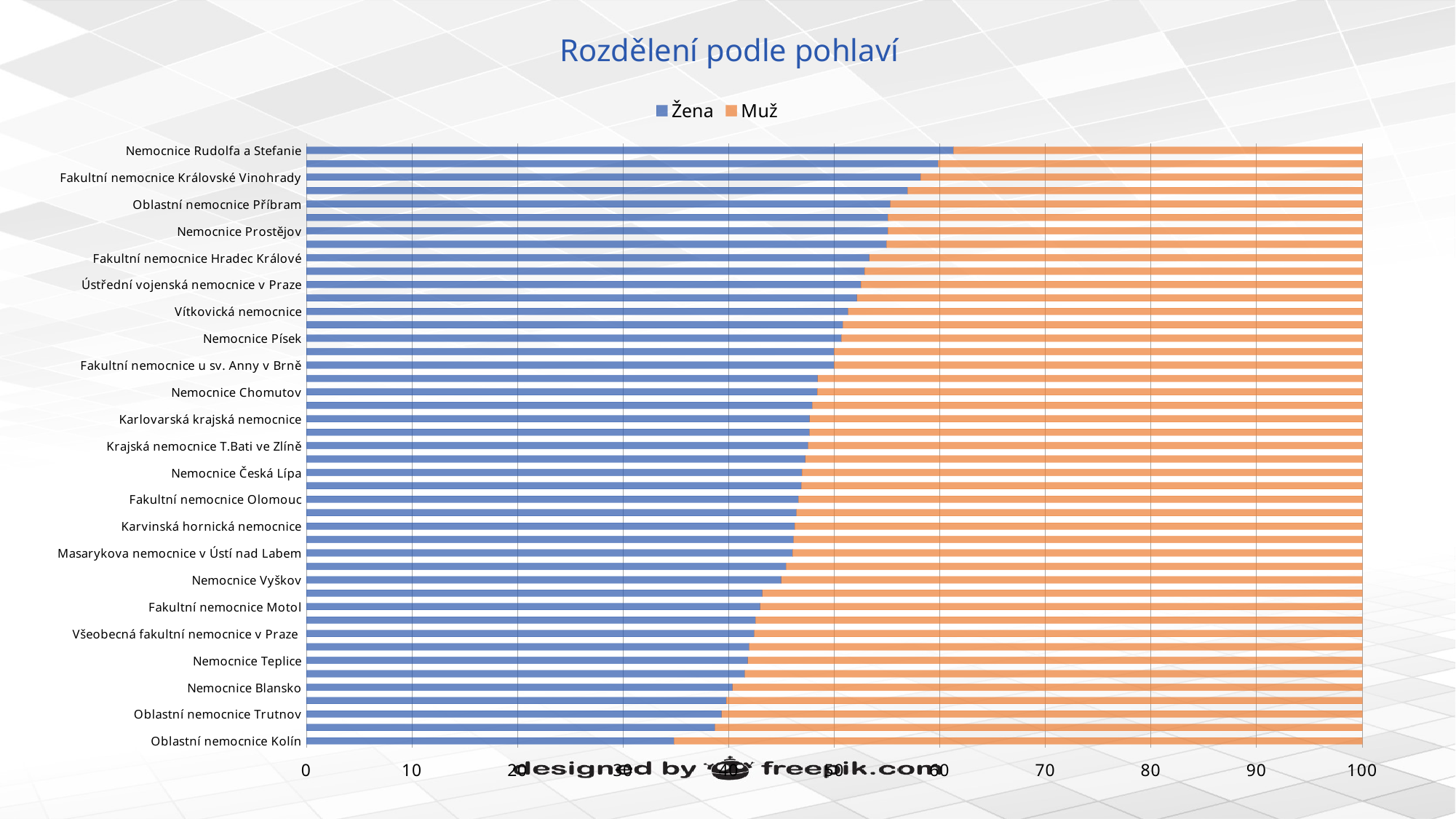
What is the title of the chart? Rozdělení podle pohlaví Is the Žena value for Oblastní nemocnice Kolín greater or less than 40? less Which has the larger Žena share: Fakultní nemocnice Královské Vinohrady or Nemocnice Teplice? Fakultní nemocnice Královské Vinohrady Is the Muž value for Nemocnice Rudolfa a Stefanie greater or less than 50? less What kind of chart is shown on the slide? Stacked bar chart Is the Žena value for Nemocnice Prostějov greater or less than 50? greater Which has the larger Muž share: Nemocnice Blansko or Nemocnice Písek? Nemocnice Blansko Among the labelled hospitals, which has the highest Žena share? Nemocnice Rudolfa a Stefanie Among the labelled hospitals, which has the lowest Žena share? Oblastní nemocnice Kolín How many series does the legend list? 2 Which series is shown in orange? Muž